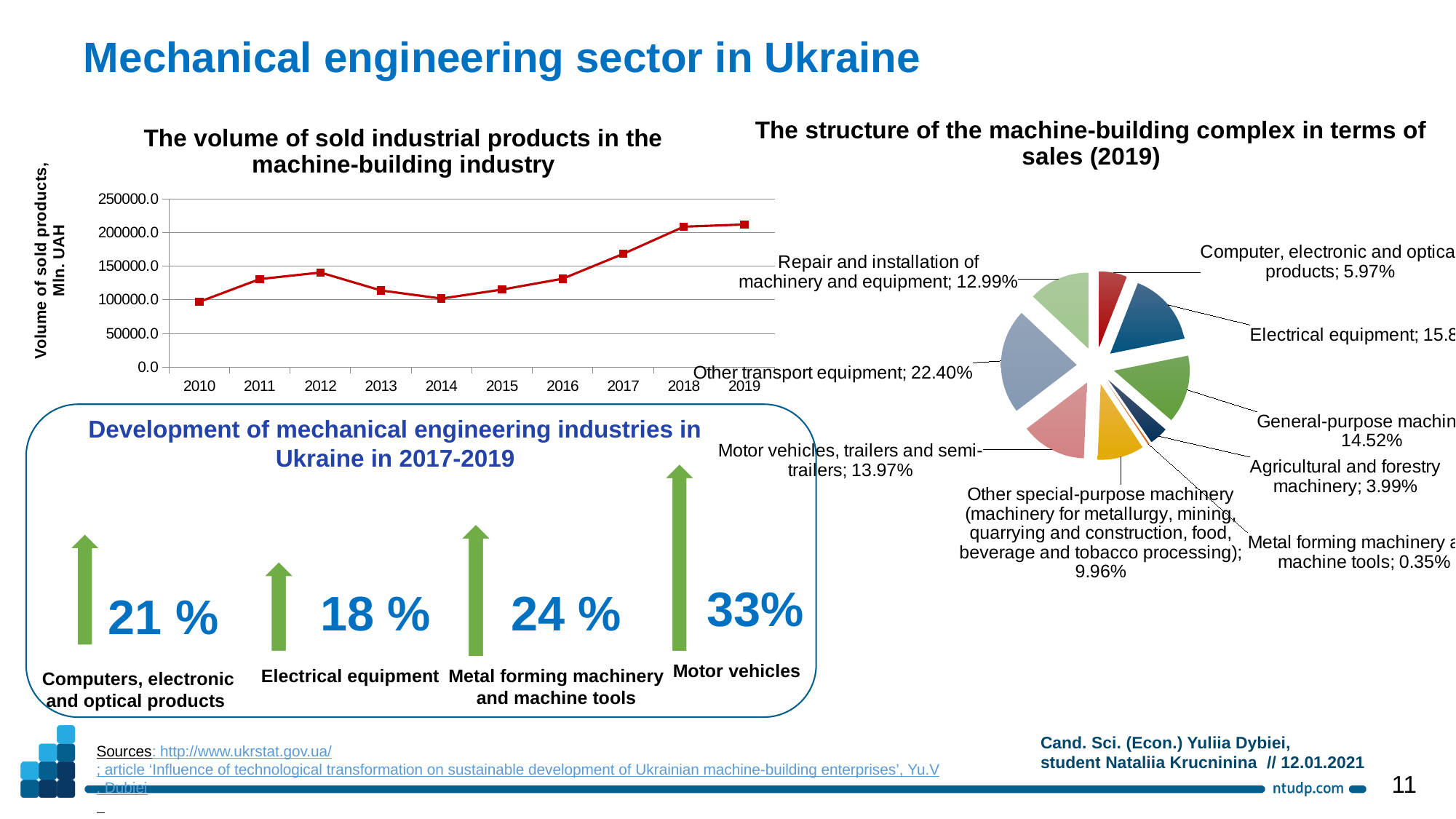
In the line chart 'The volume of sold industrial products in the machine-building industry', how many years are shown on the x axis? 10 In the line chart 'The volume of sold industrial products in the machine-building industry', is the value for 2012 greater or less than 150000.0? less In the line chart 'The volume of sold industrial products in the machine-building industry', is the value for 2017 greater or less than 150000.0? greater In the pie chart 'The structure of the machine-building complex in terms of sales (2019)', which category has the largest share? Other transport equipment In the pie chart 'The structure of the machine-building complex in terms of sales (2019)', what is the share of Other transport equipment? 22.40% In the line chart 'The volume of sold industrial products in the machine-building industry', what is the y-axis label? Volume of sold products, Mln. UAH In the line chart 'The volume of sold industrial products in the machine-building industry', does the value overall rise or fall from 2010 to 2019? rise What type of chart is 'The volume of sold industrial products in the machine-building industry'? line chart What type of chart is 'The structure of the machine-building complex in terms of sales (2019)'? pie chart In the line chart 'The volume of sold industrial products in the machine-building industry', is the value for 2018 greater or less than 200000.0? greater In the pie chart 'The structure of the machine-building complex in terms of sales (2019)', what is the share of Agricultural and forestry machinery? 3.99% In the pie chart 'The structure of the machine-building complex in terms of sales (2019)', what is the difference between the shares of Repair and installation of machinery and equipment and Computer, electronic and optical products? 7.02%